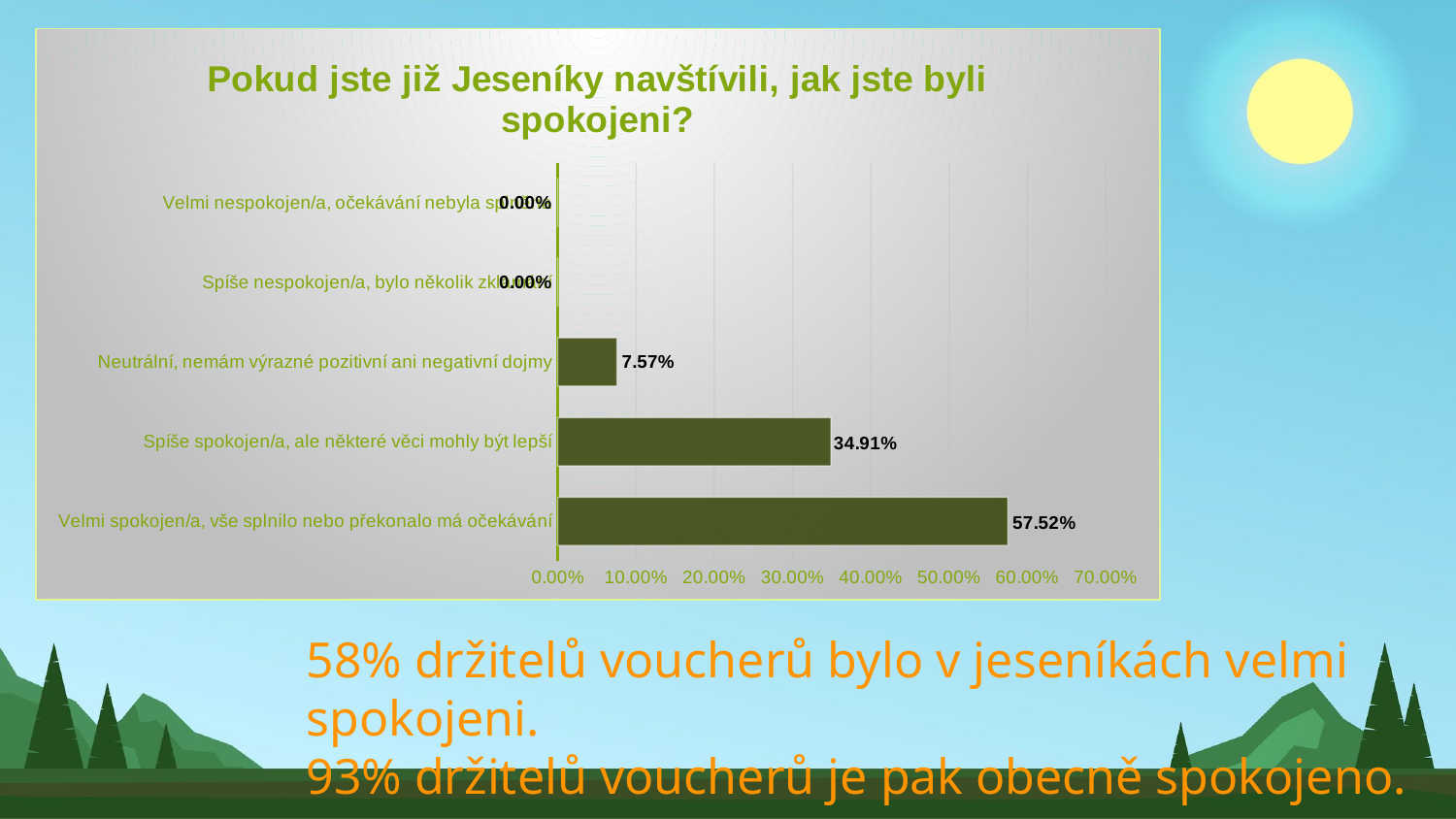
What is the value for "Spíše spokojen/a, ale některé věci mohly být lepší"? 34.91% What is the difference between the values for "Spíše spokojen/a" and "Neutrální"? 27.34% What is the value for the "Velmi nespokojen/a" category? 0.00% Which category has the highest value? Velmi spokojen/a, vše splnilo nebo překonalo má očekávání What is the difference between the values for "Velmi spokojen/a" and "Spíše spokojen/a"? 22.61% What type of chart is shown on the slide? bar chart Which is larger, the value for "Neutrální" or the value for "Spíše spokojen/a"? Spíše spokojen/a How many categories have a value of 0.00%? 2 How many categories are shown in the chart? 5 Is the value for "Velmi spokojen/a" greater or less than 50.00%? greater What is the value for "Velmi spokojen/a, vše splnilo nebo překonalo má očekávání"? 57.52% What is the value for "Neutrální, nemám výrazné pozitivní ani negativní dojmy"? 7.57%